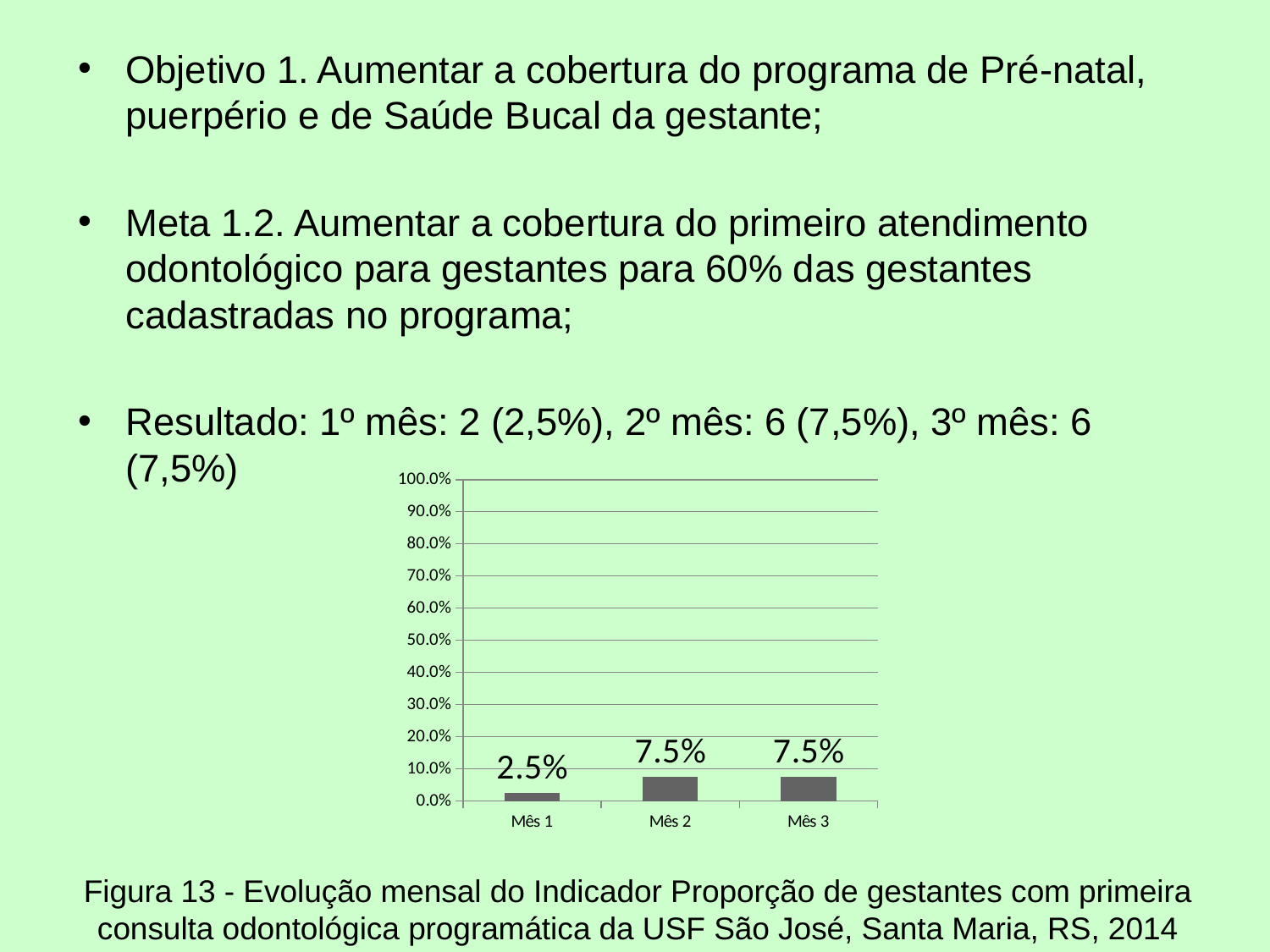
Do the values rise or fall from Mês 1 to Mês 2? rise What is the value for Mês 1? 2.5% What is the value for Mês 3? 7.5% What is the value for Mês 2? 7.5% Is the value for Mês 3 greater or less than 10.0%? less Is the value for Mês 1 greater or less than 10.0%? less Which category has the lowest value? Mês 1 Which is larger, the value for Mês 1 or the value for Mês 2? Mês 2 How many categories are shown on the x axis? 3 What kind of chart is shown? bar chart What is the highest value shown on the y axis? 100.0% What is the difference between the values for Mês 2 and Mês 1? 5.0%